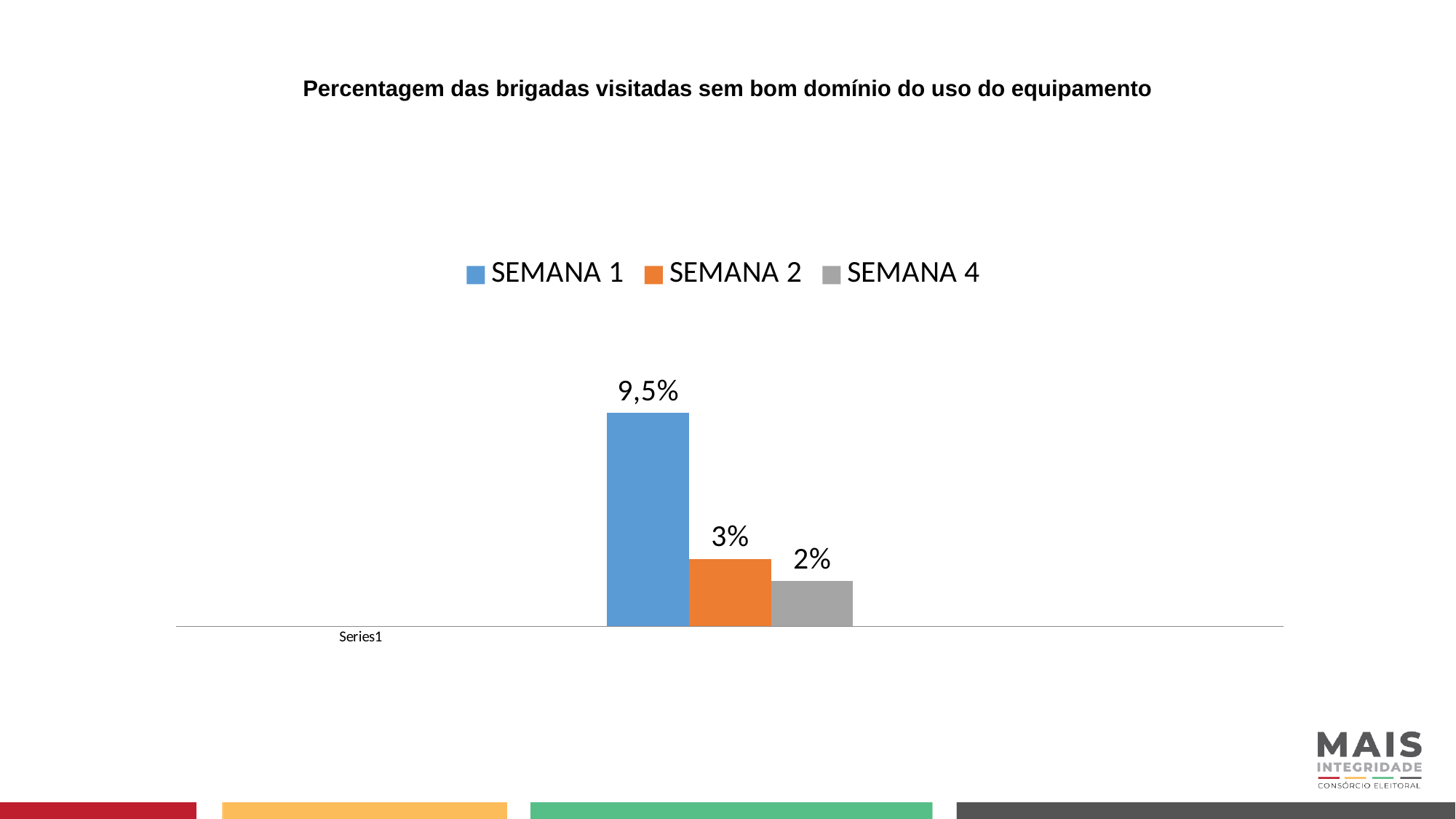
What is the difference between the values for SEMANA 1 and SEMANA 2? 6,5% Which is larger, the value for SEMANA 1 or the value for SEMANA 4? SEMANA 1 How many series does the legend list? 3 What is the value for SEMANA 4? 2% What kind of chart is shown on the slide? Bar chart What is the value for SEMANA 1? 9,5% Which series has the lowest value? SEMANA 4 What is the value for SEMANA 2? 3% Which series has the highest value? SEMANA 1 What is the title of the chart? Percentagem das brigadas visitadas sem bom domínio do uso do equipamento Do the values rise or fall from SEMANA 1 to SEMANA 4? Fall What is the difference between the values for SEMANA 2 and SEMANA 4? 1%